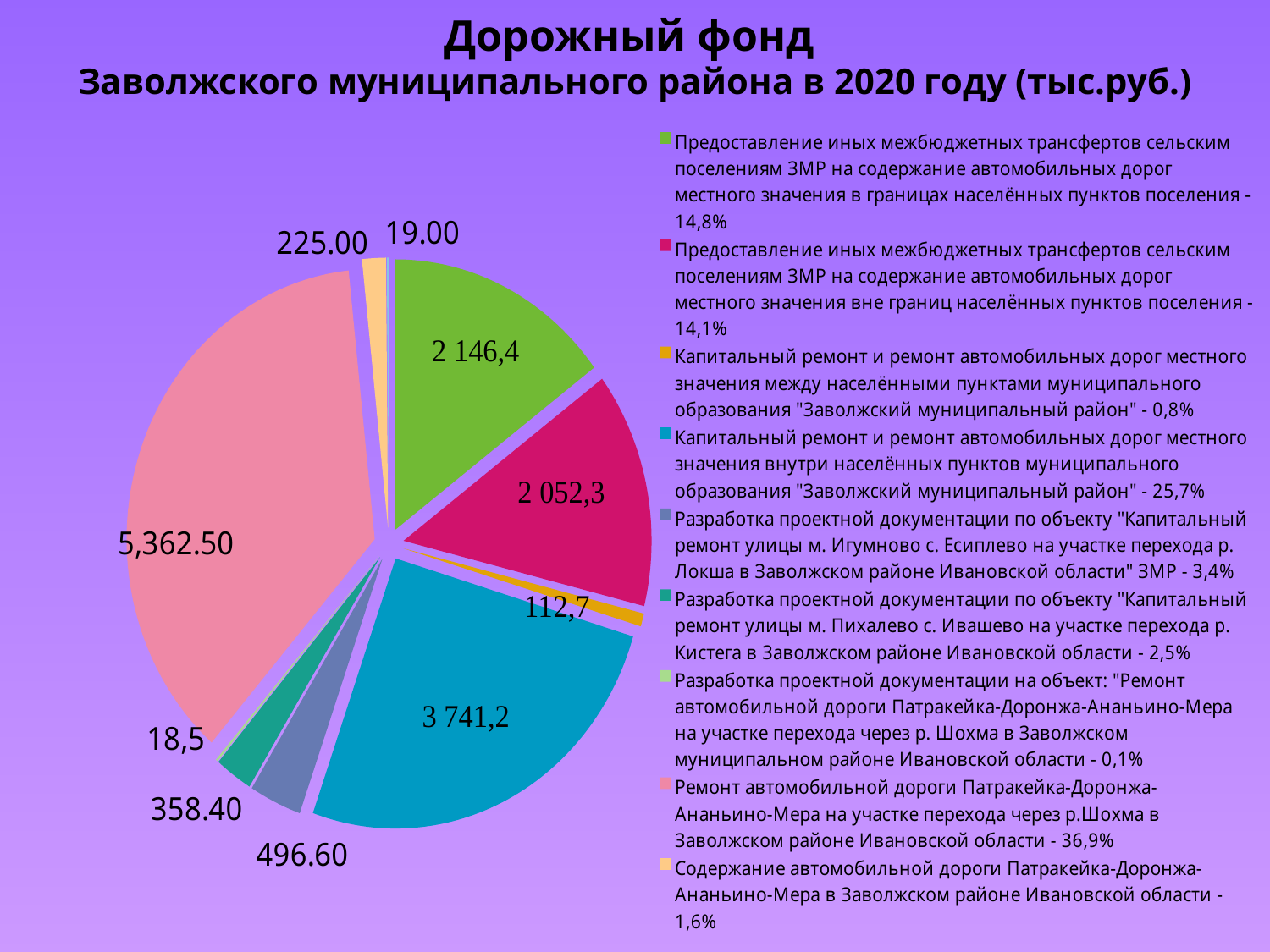
What value is shown for the slice 'Капитальный ремонт и ремонт автомобильных дорог местного значения внутри населённых пунктов муниципального образования "Заволжский муниципальный район"'? 3 741,2 What kind of chart is shown on the slide? pie chart According to the legend, what share of the pie does 'Капитальный ремонт и ремонт автомобильных дорог местного значения внутри населённых пунктов муниципального образования "Заволжский муниципальный район"' represent? 25,7% What value is shown for the slice 'Предоставление иных межбюджетных трансфертов сельским поселениям ЗМР на содержание автомобильных дорог местного значения в границах населённых пунктов поселения'? 2 146,4 How many slices does the pie chart have? 10 Which is larger: the slice labelled 496.60 or the slice labelled 358.40? 496.60 What is the largest value shown on the pie chart? 5,362.50 What is the difference between the values 2 146,4 and 2 052,3 shown on the pie chart? 94,1 According to the legend, what share of the pie does 'Ремонт автомобильной дороги Патракейка-Доронжа-Ананьино-Мера на участке перехода через р.Шохма в Заволжском районе Ивановской области' represent? 36,9% What is the title of the chart on the slide? Дорожный фонд Заволжского муниципального района в 2020 году (тыс.руб.) What value is shown for the slice 'Содержание автомобильной дороги Патракейка-Доронжа-Ананьино-Мера в Заволжском районе Ивановской области'? 225.00 What is the smallest value shown on the pie chart? 18,5